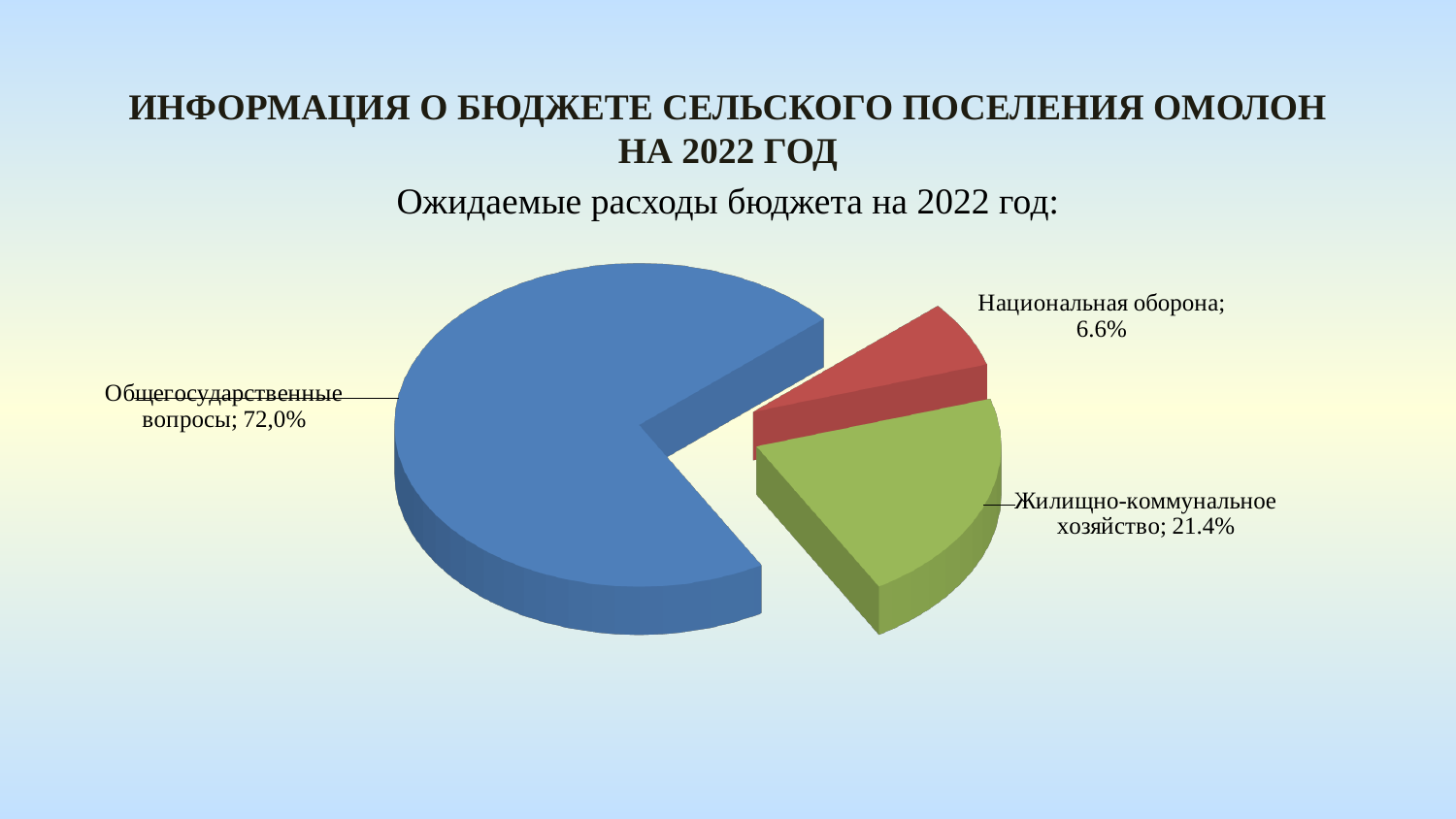
How many slices does the pie chart have? 3 Which is larger: the slice for Жилищно-коммунальное хозяйство or the slice for Национальная оборона? Жилищно-коммунальное хозяйство What is the subtitle written directly above the pie chart? Ожидаемые расходы бюджета на 2022 год: What kind of chart is shown on the slide? Pie chart Which category has the largest slice of the pie? Общегосударственные вопросы Which category has the smallest slice of the pie? Национальная оборона What is the difference in percentage points between Жилищно-коммунальное хозяйство (21.4%) and Национальная оборона (6.6%)? 14.8 percentage points What share of the pie does Жилищно-коммунальное хозяйство have? 21.4% What share of the pie does Национальная оборона have? 6.6% What share of the pie does Общегосударственные вопросы have? 72,0% Is the share for Общегосударственные вопросы greater or less than 50%? greater What colour is the slice for Национальная оборона? Red